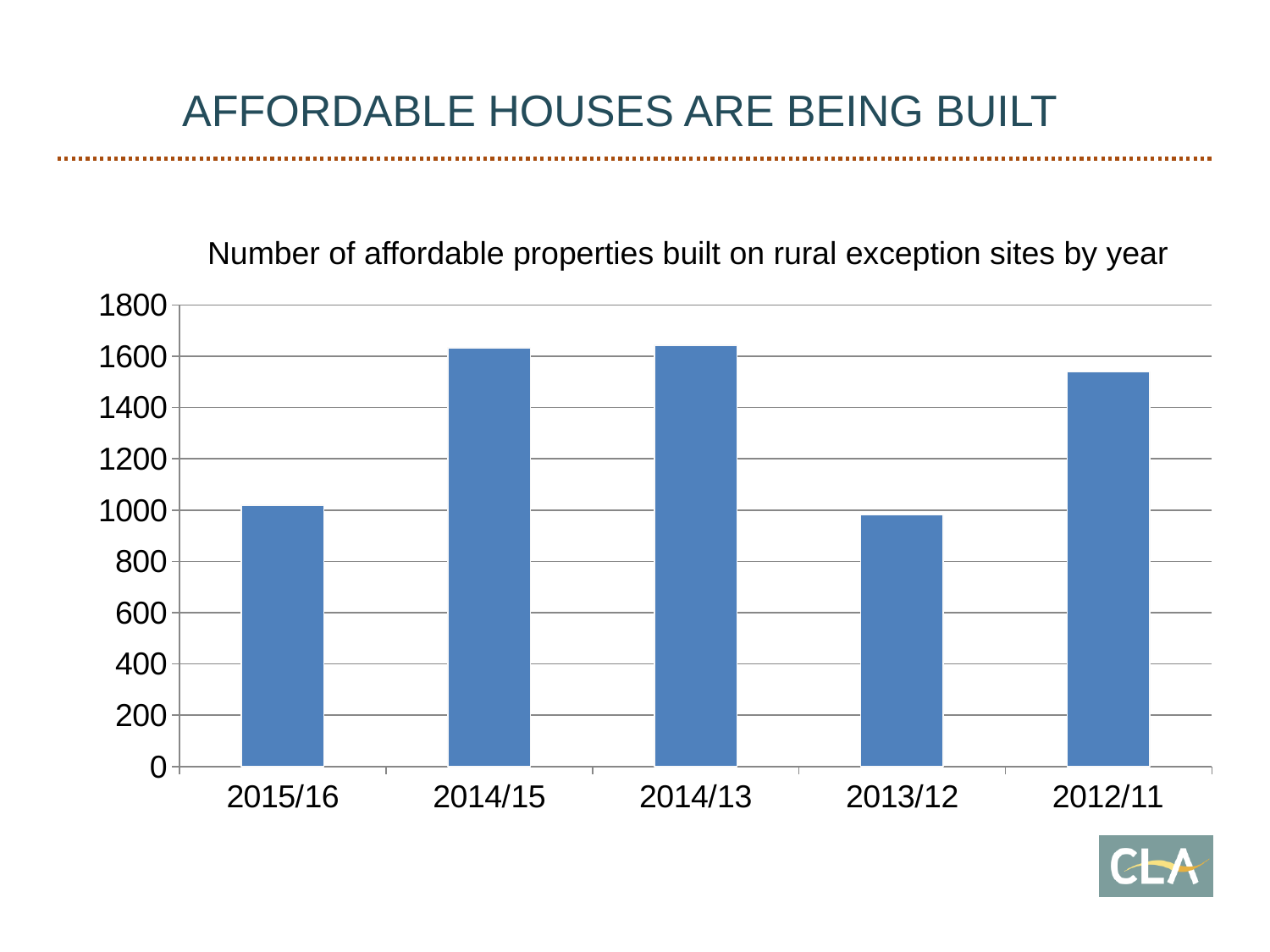
Is the value for 2015/16 greater or less than 1200? less Which has the larger value, 2012/11 or 2013/12? 2012/11 What kind of chart is shown on the slide? bar chart Which has the larger value, 2014/13 or 2012/11? 2014/13 How many years (categories) are shown on the x axis of the chart? 5 What is the highest value shown on the y axis of the chart? 1800 Which has the larger value, 2014/15 or 2015/16? 2014/15 Is the value for 2014/15 greater or less than 1600? greater What is the title of the chart? Number of affordable properties built on rural exception sites by year Is the value for 2012/11 greater or less than 1400? greater